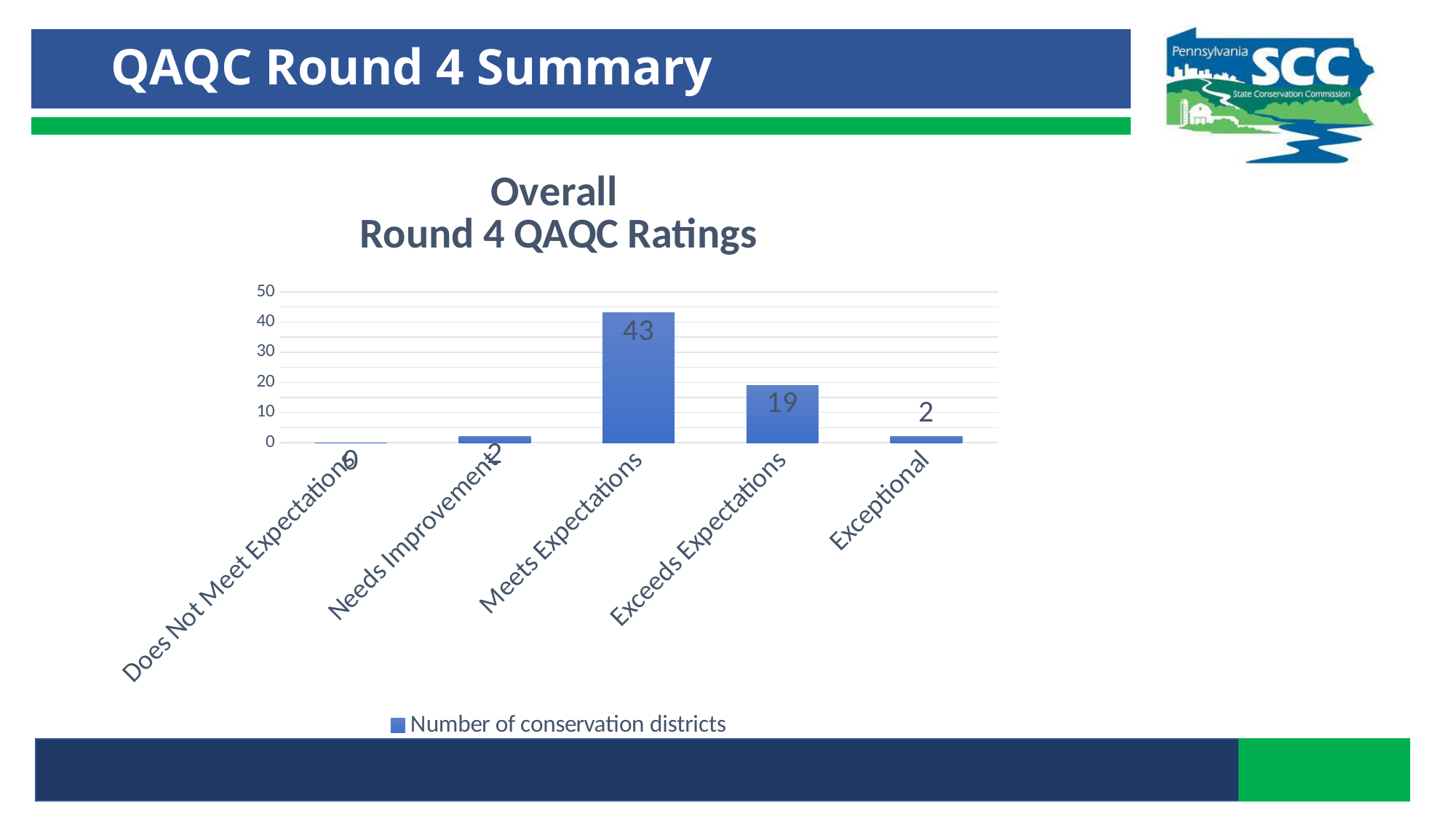
How many series does the legend list? 1 What is the difference between the number of districts rated Meets Expectations and those rated Exceeds Expectations? 24 Which has more conservation districts: Exceeds Expectations or Exceptional? Exceeds Expectations How many conservation districts received a rating of Exceeds Expectations? 19 How many conservation districts received a rating of Exceptional? 2 What type of chart is shown on the slide? bar chart How many conservation districts received a rating of Meets Expectations? 43 Which rating category has the lowest number of conservation districts? Does Not Meet Expectations Is the value for Meets Expectations greater or less than 40? greater Which rating category has the highest number of conservation districts? Meets Expectations How many rating categories are shown on the x axis? 5 What is the title of the chart? Overall Round 4 QAQC Ratings